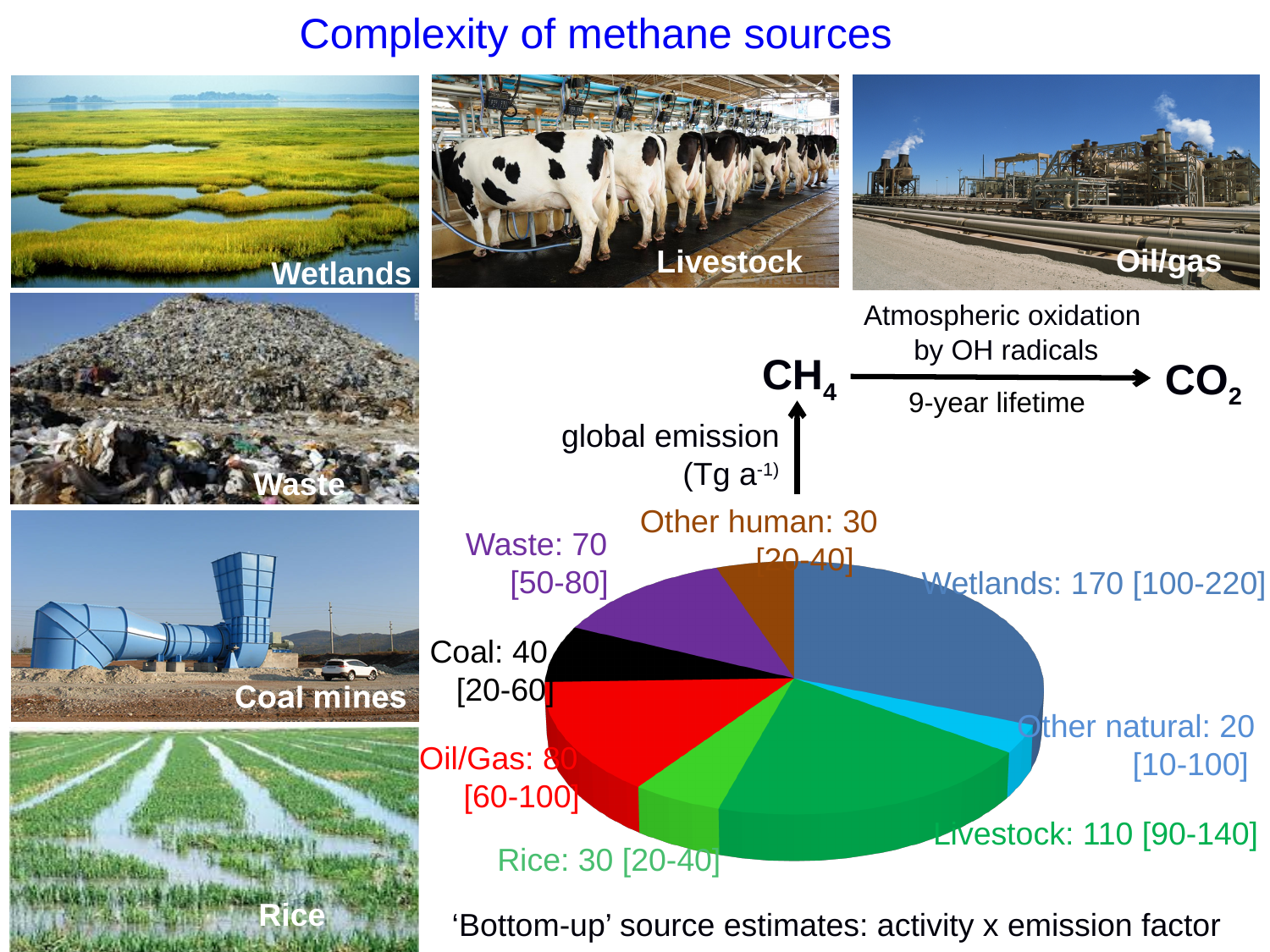
Which source has the largest slice in the pie chart? Wetlands How many source categories are shown in the pie chart? 8 What uncertainty range is given for Waste in the pie chart? [50-80] Which is larger in the pie chart, the value for Oil/Gas or the value for Waste? Oil/Gas What kind of chart is shown on the slide? pie chart Which source has the smallest slice in the pie chart? Other natural What is the total of all the emission values shown in the pie chart? 550 What is the difference between the Wetlands and Livestock emission values in the pie chart? 60 What is the global methane emission value for Wetlands in the pie chart? 170 What is the emission value for Livestock in the pie chart? 110 What is the emission value for Coal in the pie chart? 40 What is the emission value for Oil/Gas in the pie chart? 80